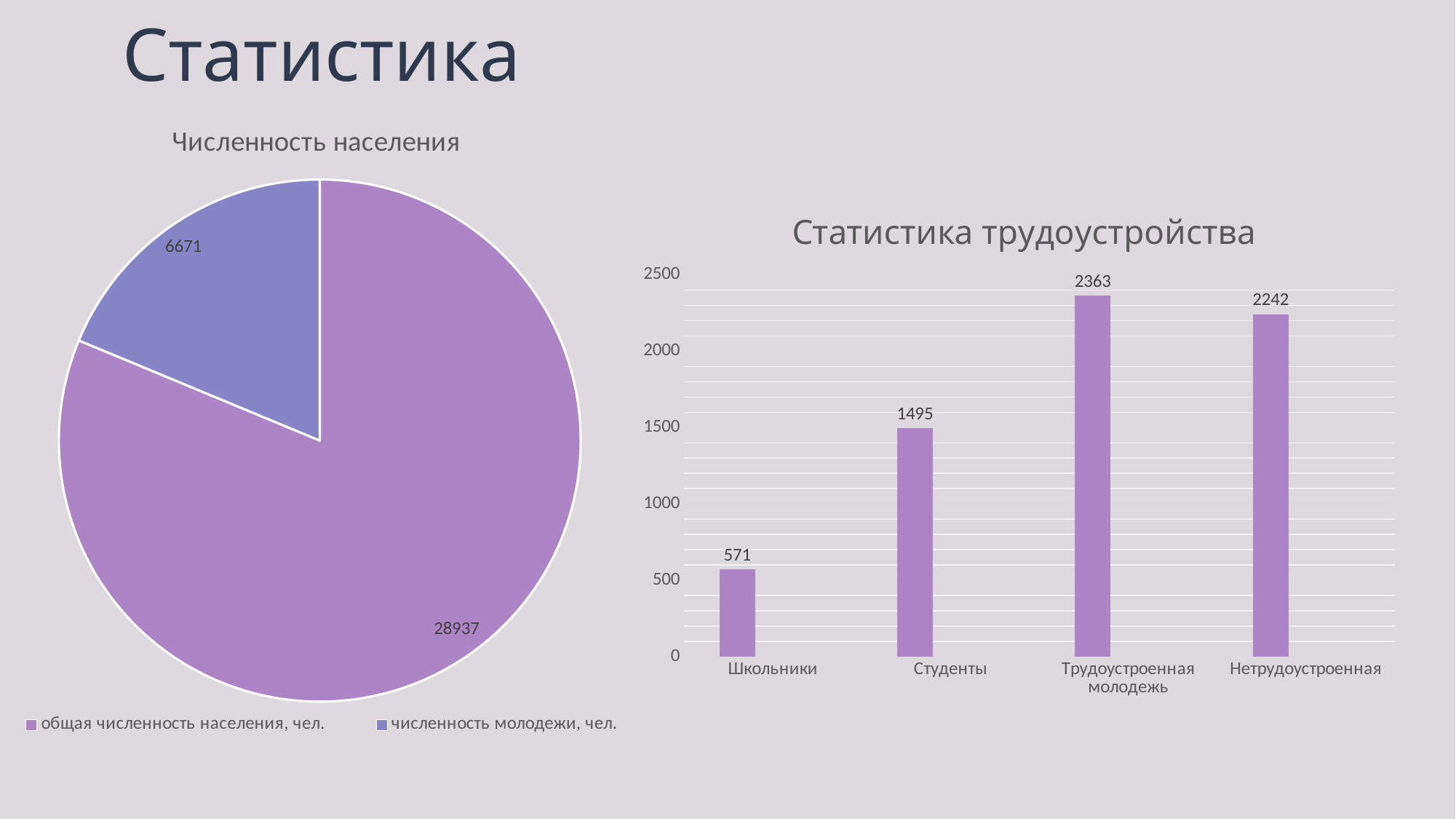
What kind of chart is 'Численность населения'? Pie chart How many categories are shown in the bar chart 'Статистика трудоустройства'? 4 In the bar chart 'Статистика трудоустройства', which category has the lowest value? Школьники What kind of chart is 'Статистика трудоустройства'? Bar chart In the pie chart 'Численность населения', what is the value for 'численность молодежи, чел.'? 6671 In the bar chart 'Статистика трудоустройства', which is larger: 'Студенты' or 'Школьники'? Студенты In the pie chart 'Численность населения', what is the difference between the two slices? 22266 In the bar chart 'Статистика трудоустройства', what is the difference between 'Трудоустроенная молодежь' and 'Нетрудоустроенная'? 121 In the pie chart 'Численность населения', what share of the total does 'численность молодежи, чел.' represent? 18.7% In the pie chart 'Численность населения', what is the value for 'общая численность населения, чел.'? 28937 In the bar chart 'Статистика трудоустройства', which category has the highest value? Трудоустроенная молодежь In the bar chart 'Статистика трудоустройства', what is the value for 'Студенты'? 1495